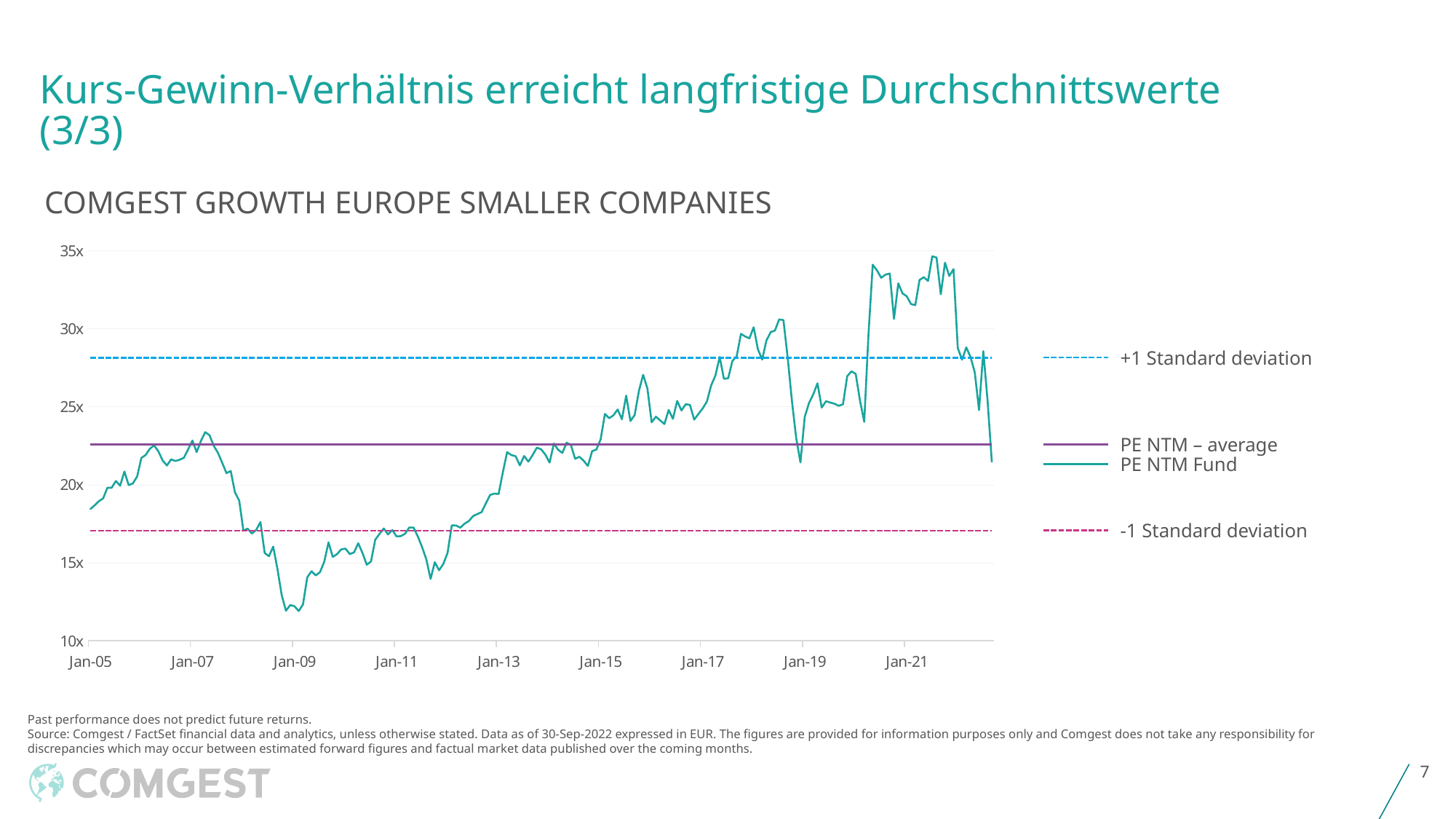
Is the PE NTM Fund value at Jan-09 greater or less than 15x? less Is the lowest point of the PE NTM Fund line closer to Jan-09 or to Jan-11? Jan-09 Which legend entry is drawn as a solid purple line? PE NTM – average What kind of chart is shown on the slide? line chart What is the title shown above the chart? COMGEST GROWTH EUROPE SMALLER COMPANIES Is the +1 Standard deviation line greater or less than 25x? greater Is the PE NTM Fund value at Jan-21 greater or less than 30x? greater How many series does the legend list? 4 Does the PE NTM Fund line rise or fall between Jan-07 and Jan-09? fall